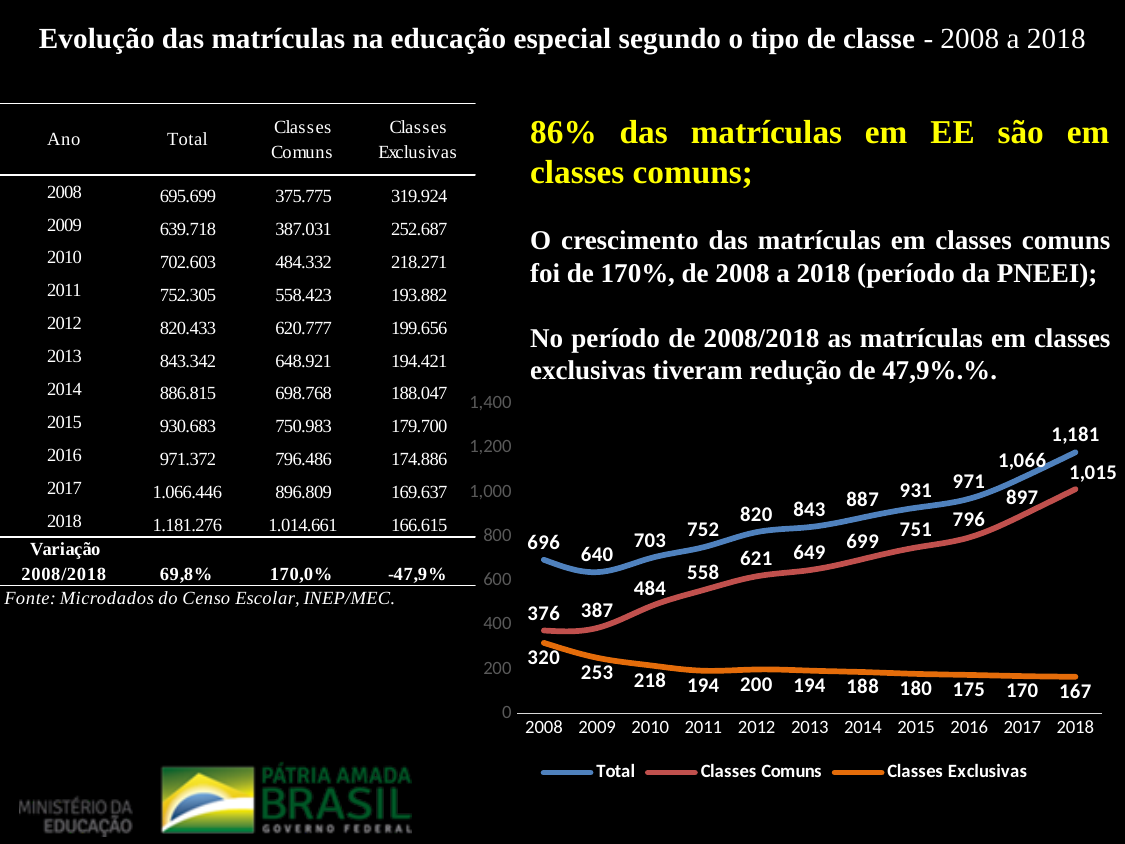
How many series does the chart legend list? 3 What is the value of the Total series in 2018? 1,181 In which year is the Classes Exclusivas series at its lowest? 2018 What is the difference between the Total value in 2018 and the Total value in 2008? 485 What is the value of the Classes Exclusivas series in 2008? 320 In which year is the Total series at its highest? 2018 What kind of chart is shown on the slide? line chart Does the Classes Exclusivas series rise or fall from 2008 to 2018? fall Which colour is used for the Classes Comuns line in the chart? red Which is larger in 2009: the Classes Comuns value or the Classes Exclusivas value? Classes Comuns What is the value of the Classes Comuns series in 2012? 621 How many years are plotted along the x axis of the chart? 11